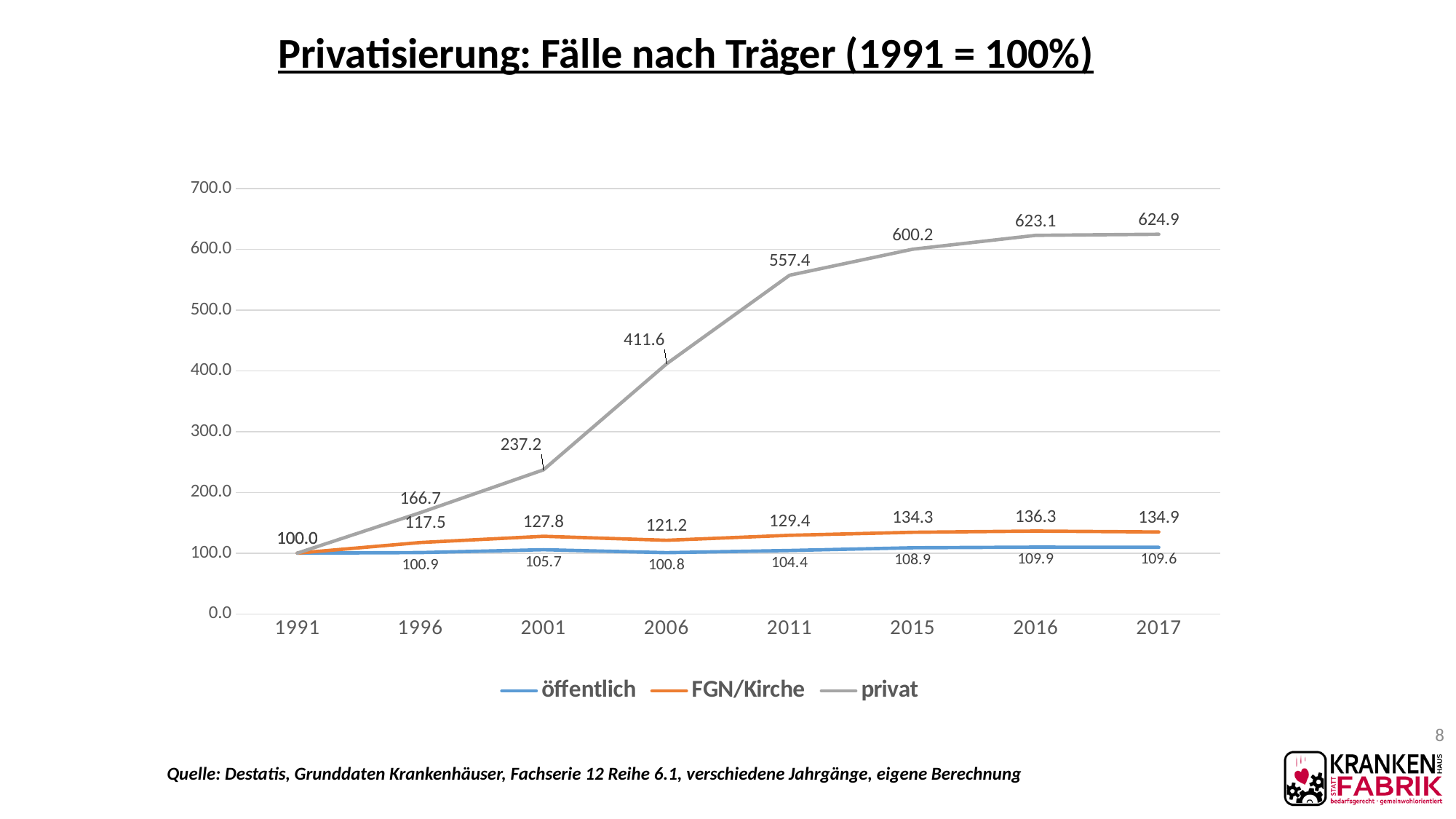
How many years are shown on the x axis? 8 What is the value for FGN/Kirche in 2006? 121.2 What type of chart is shown on the slide? line chart Does the privat series rise or fall from 1991 to 2017? rise Which colour is used for the privat series? grey What is the value for öffentlich in 2015? 108.9 In which year is the öffentlich series at its lowest value? 1991 In which year does the privat series reach its highest value? 2017 How many series does the legend list? 3 What is the difference between the privat value in 2017 and the privat value in 1991? 524.9 What is the value for privat in 2011? 557.4 Which is larger in 2016: the value for FGN/Kirche or the value for öffentlich? FGN/Kirche